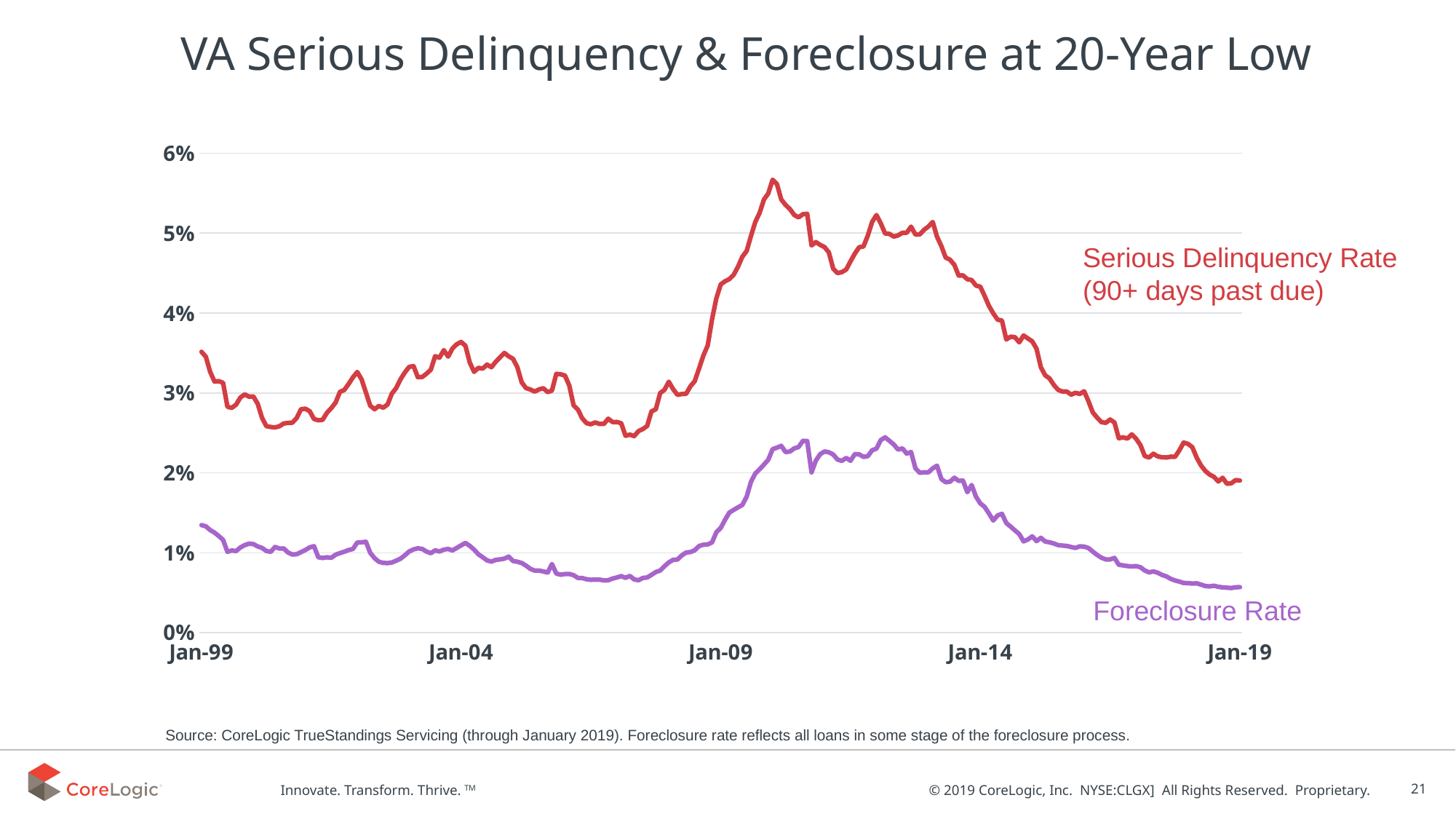
Does the Serious Delinquency Rate rise or fall between Jan-14 and Jan-19? fall How many series are plotted on the chart? 2 Is the peak of the Foreclosure Rate greater or less than 2%? greater Is the Serious Delinquency Rate at Jan-14 greater or less than 4%? greater Which series is higher at Jan-19, the Serious Delinquency Rate or the Foreclosure Rate? Serious Delinquency Rate What kind of chart is shown on the slide? line chart Is the Serious Delinquency Rate at Jan-99 greater or less than 3%? greater What is the title of the chart on the slide? VA Serious Delinquency & Foreclosure at 20-Year Low Which colour is used for the Foreclosure Rate line? purple